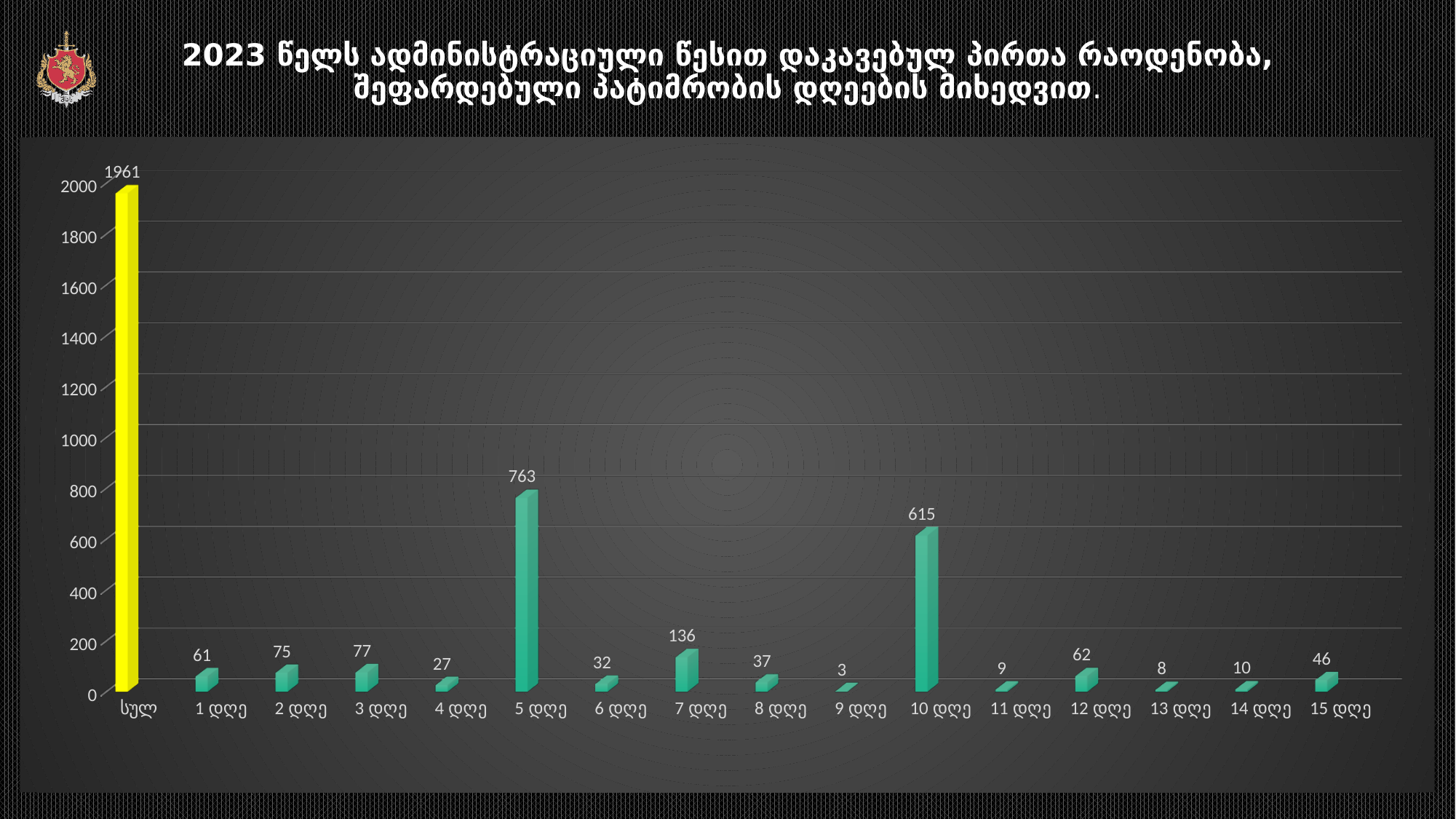
What is the value for "7 დღე"? 136 What is the value for "10 დღე"? 615 What kind of chart is shown on the slide? bar chart Excluding the "სულ" total bar, which day category has the highest value? 5 დღე What colour is the "სულ" bar? yellow What is the difference between the values for "5 დღე" and "10 დღე"? 148 Which is larger, the value for "2 დღე" or the value for "12 დღე"? 2 დღე Excluding the "სულ" total bar, which day category has the lowest value? 9 დღე What is the value for the "სულ" bar? 1961 How many categories are shown on the x axis? 16 What is the difference between the values for "3 დღე" and "4 დღე"? 50 What is the value for "5 დღე"? 763